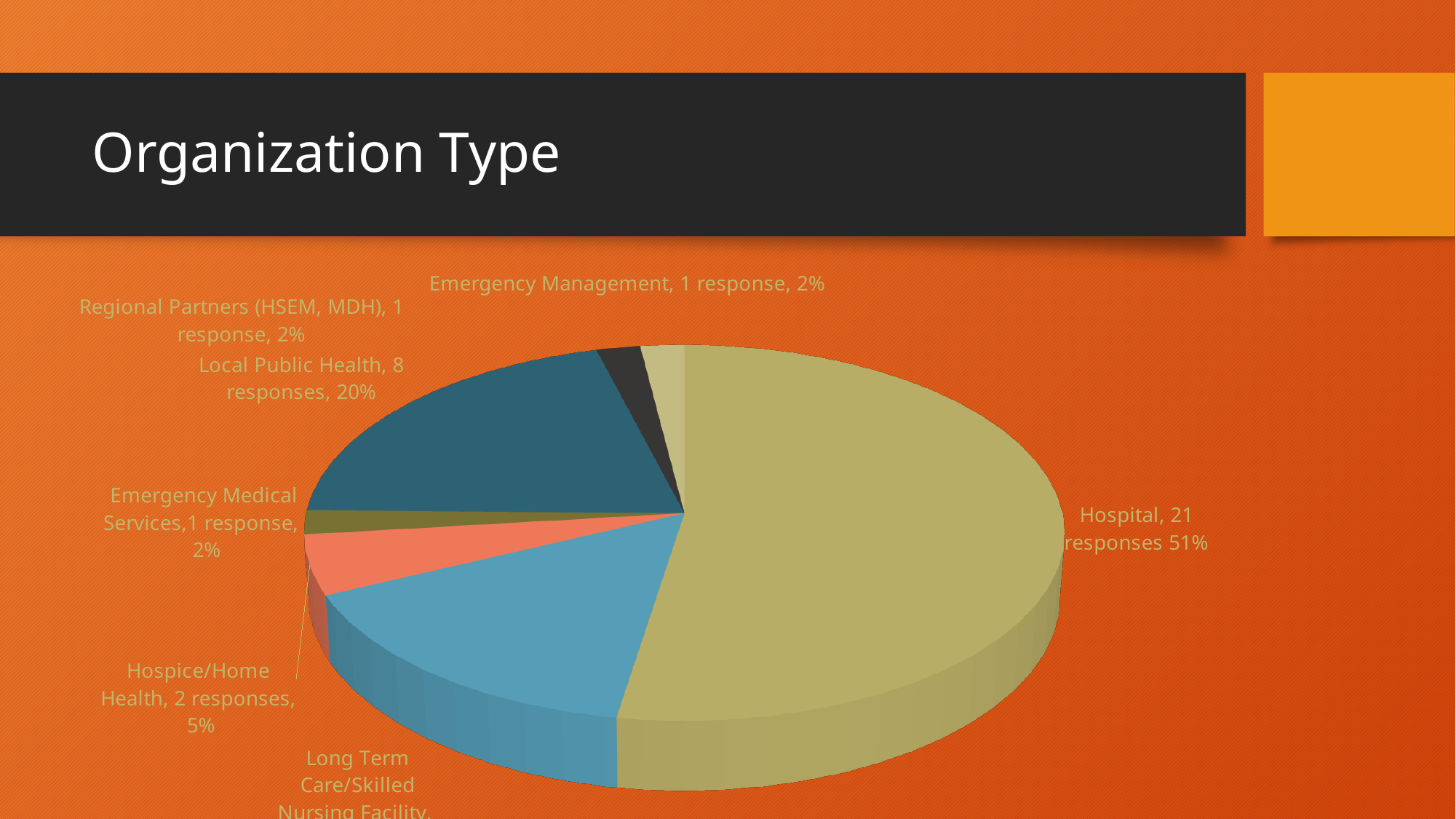
What is the difference in responses between Hospital and Local Public Health? 13 How many responses are shown for Local Public Health? 8 responses What percentage share does Hospital have in the pie chart? 51% Which has more responses, Local Public Health or Hospice/Home Health? Local Public Health What is the title of the slide containing the pie chart? Organization Type How many responses are shown for Hospital? 21 responses How many responses are shown for Emergency Management? 1 response What percentage share does Local Public Health have? 20% Which organization type has the largest slice of the pie? Hospital What type of chart is shown on the slide? pie chart How many organization types (slices) are shown in the pie chart? 7 What percentage share does Hospice/Home Health have? 5%